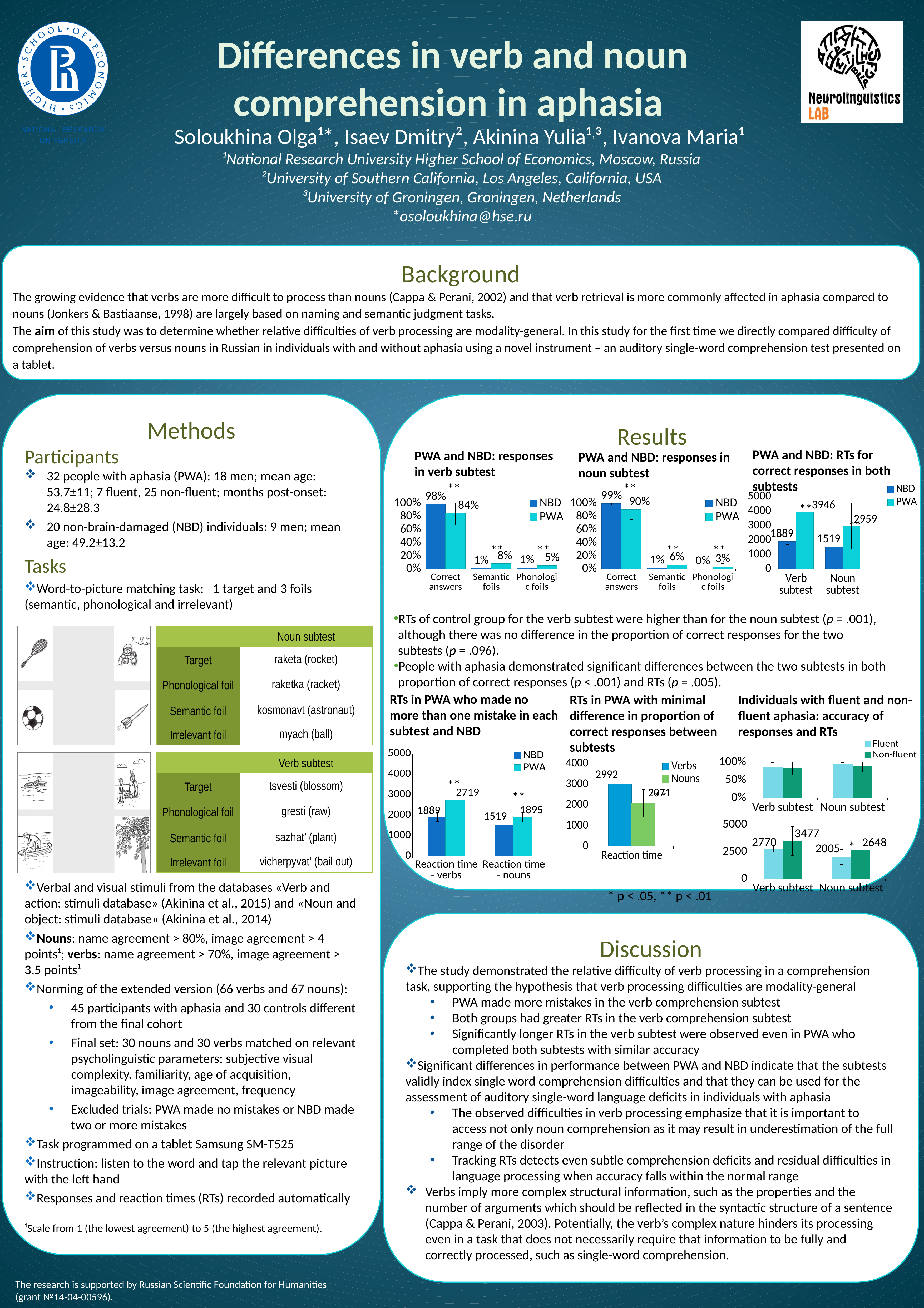
In the chart 'PWA and NBD: responses in verb subtest', what percentage of semantic foils did the PWA group choose? 8% In the RT chart for 'Individuals with fluent and non-fluent aphasia', what is the non-fluent value for the verb subtest? 3477 In the chart 'PWA and NBD: responses in noun subtest', what is the difference between the NBD and PWA percentages of correct answers? 9% In the chart 'PWA and NBD: RTs for correct responses in both subtests', what is the difference between the NBD verb subtest and noun subtest RTs? 370 In the chart 'PWA and NBD: RTs for correct responses in both subtests', what is the PWA value for the verb subtest? 3946 In the chart 'PWA and NBD: responses in noun subtest', what percentage of correct answers did the NBD group give? 99% In the chart 'RTs in PWA with minimal difference in proportion of correct responses between subtests', how many series does the legend list? 2 In the chart 'RTs in PWA with minimal difference in proportion of correct responses between subtests', what is the reaction time for nouns? 2071 In the chart 'PWA and NBD: RTs for correct responses in both subtests', which group has the higher RT in the noun subtest, NBD or PWA? PWA In the chart 'RTs in PWA who made no more than one mistake in each subtest and NBD', what is the PWA reaction time for verbs? 2719 In the chart 'PWA and NBD: responses in verb subtest', what percentage of correct answers did the PWA group give? 84% What type of chart is 'PWA and NBD: responses in verb subtest'? Bar chart